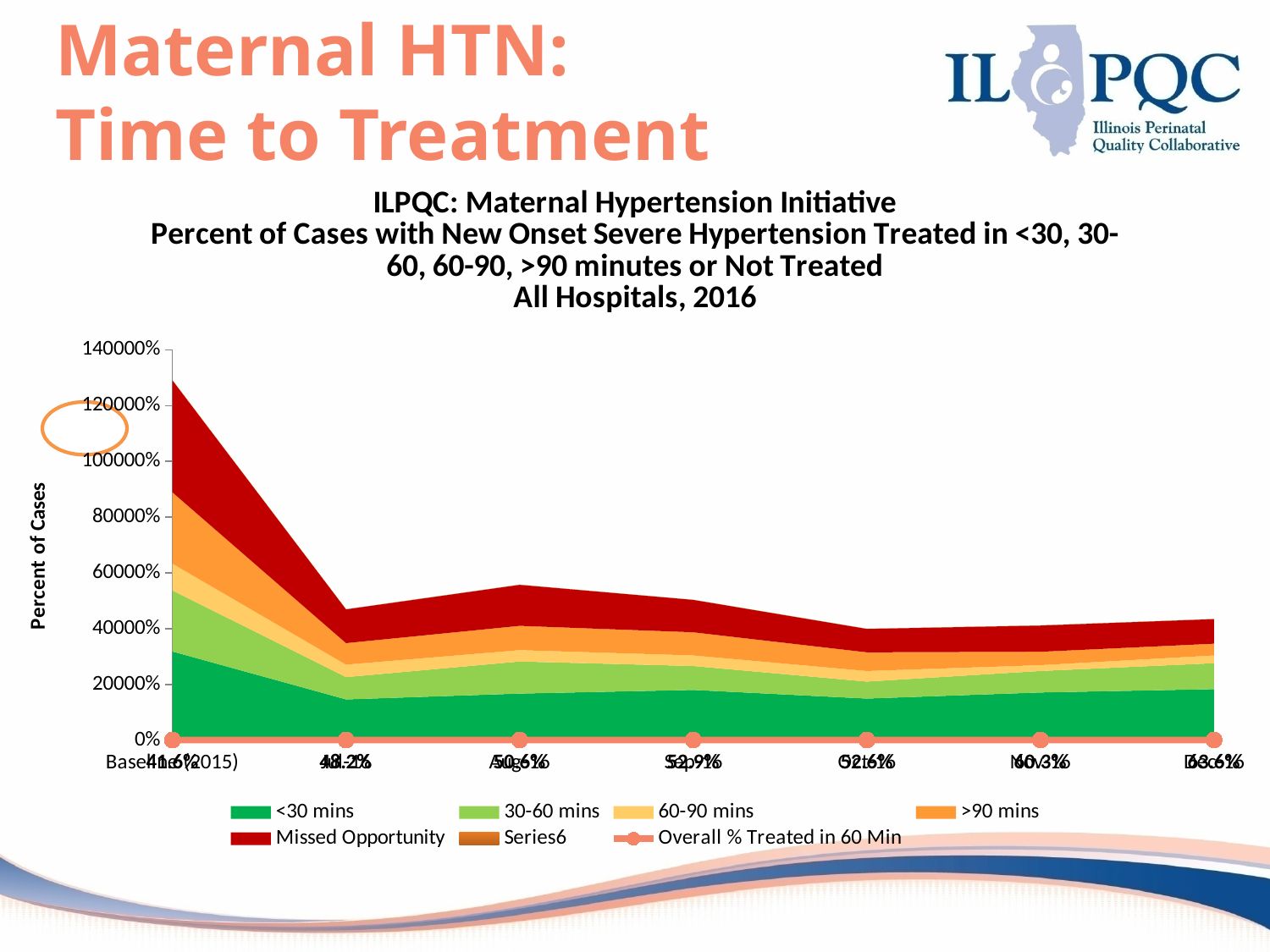
Which legend entry is shown in red? Missed Opportunity Is the Overall % Treated in 60 Min line greater or less than 20000% at every point? less Is the top of the stacked area at the last x-axis point greater or less than 60000%? less Is the top of the stacked area at the Baseline (2015) point greater or less than 120000%? greater At which x-axis point does the stacked area reach its highest total? Baseline (2015) Does the total height of the stacked area rise or fall from the Baseline (2015) point to the next point? fall How many points are plotted along the x axis of the chart? 7 What is the title of the y axis of the chart? Percent of Cases What kind of chart is shown on the slide? area and line chart How many series does the chart's legend list? 7